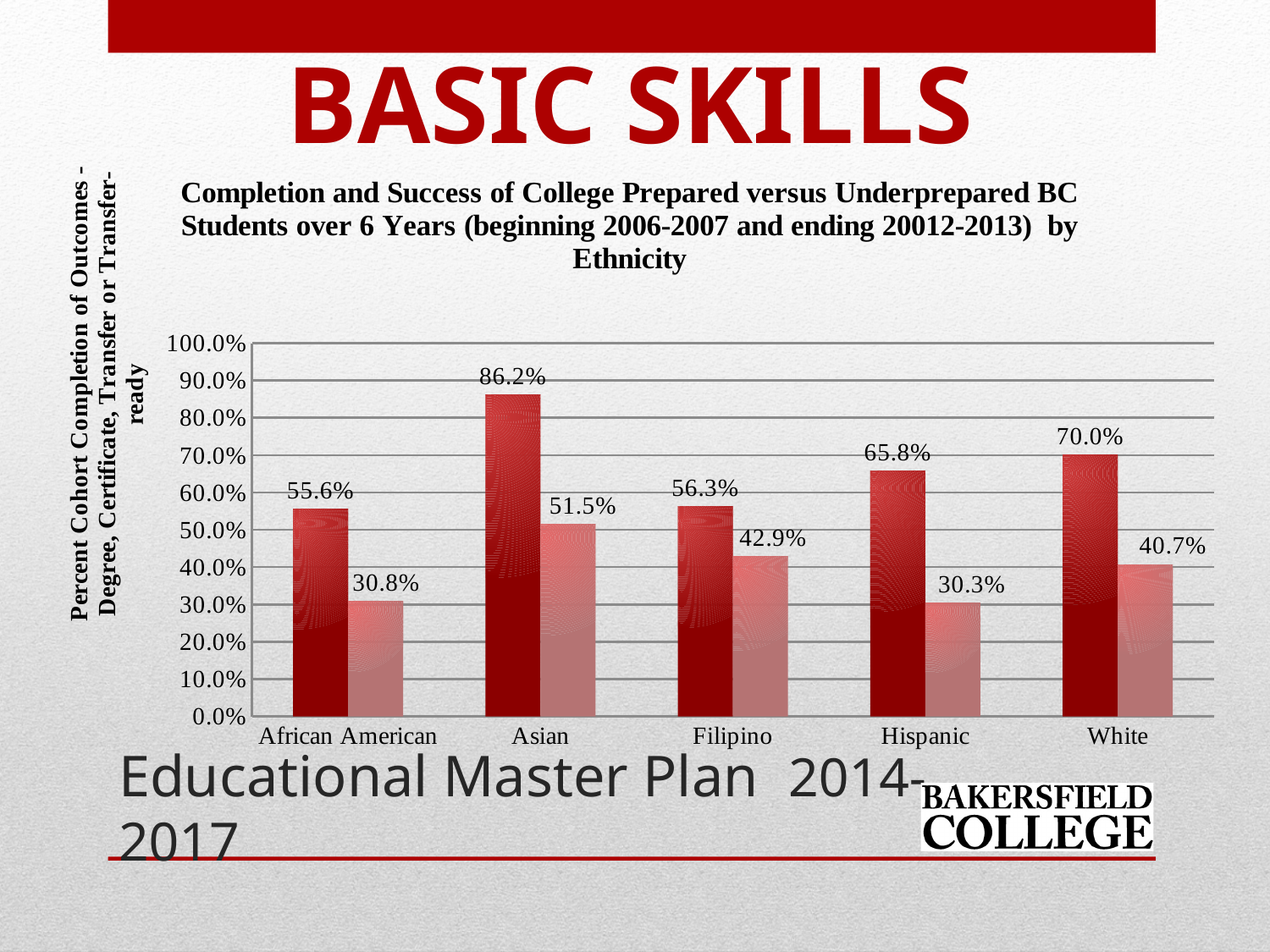
What is the label on the vertical axis of the chart? Percent Cohort Completion of Outcomes - Degree, Certificate, Transfer or Transfer-ready Which ethnicity has the highest dark red (first) bar? Asian What is the value of the dark red (first) bar for Asian? 86.2% How many ethnicity categories are shown on the x axis? 5 What is the difference between the dark red and lighter red bars for White? 29.3% What kind of chart is shown on the slide? Bar chart Which is larger: the dark red bar for Hispanic or the dark red bar for White? White What is the value of the lighter red (second) bar for Hispanic? 30.3% Which ethnicity has the lowest lighter red (second) bar? Hispanic What is the difference between the dark red and lighter red bars for Asian? 34.7% What is the value of the dark red (first) bar for White? 70.0% What is the value of the lighter red (second) bar for Filipino? 42.9%